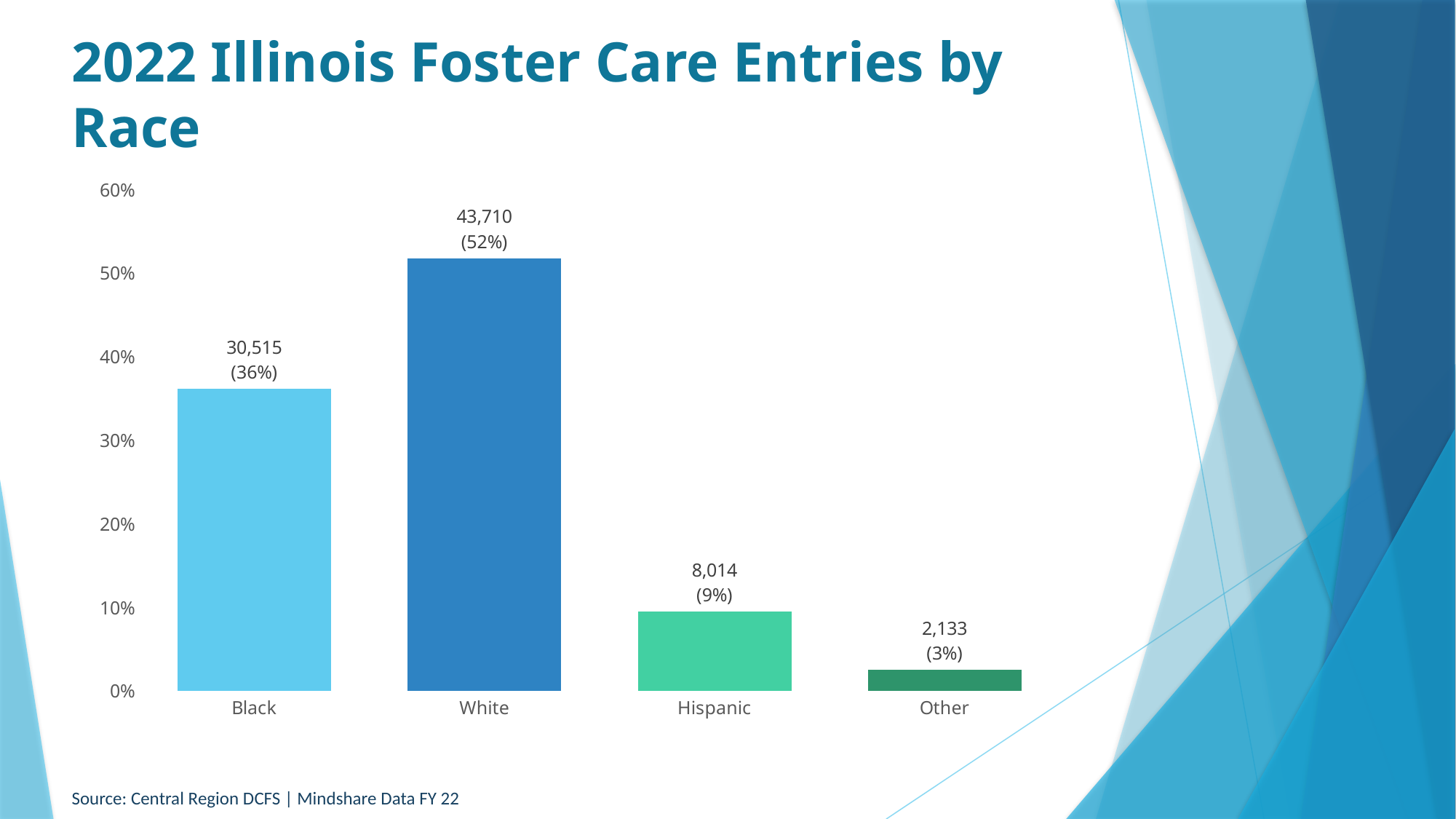
What is the title of the slide? 2022 Illinois Foster Care Entries by Race Which race category has the lowest number of foster care entries? Other What percentage of foster care entries does the White category represent? 52% What is the number of foster care entries for Black children? 30,515 What is the number of foster care entries for the Hispanic category? 8,014 What is the difference in foster care entries between the White and Black categories? 13,195 What percentage of foster care entries does the Other category represent? 3% Which race category has the highest number of foster care entries? White Which category has more foster care entries, Hispanic or Other? Hispanic What type of chart is shown on the slide? Bar chart Is the value for Black greater or less than 30%? greater How many race categories are shown in the chart? 4